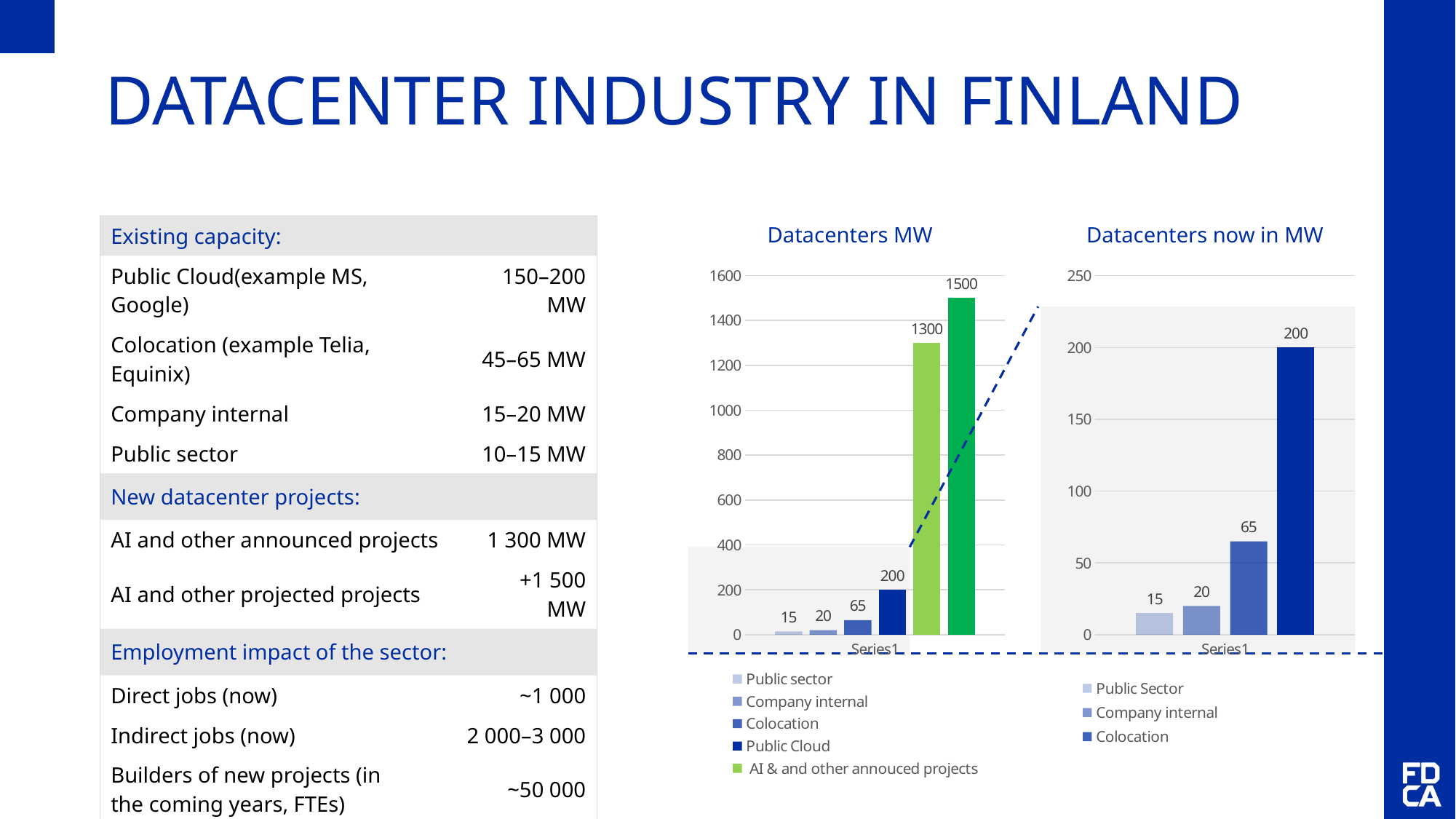
In the "Datacenters MW" chart, what is the value for AI & and other annouced projects? 1300 In the "Datacenters now in MW" chart, what is the value of the tallest bar? 200 In the "Datacenters MW" chart, which legend series has the lowest value? Public sector In the "Datacenters MW" chart, what is the highest value shown on a data label? 1500 In the "Datacenters MW" chart, what is the value for Colocation? 65 In the "Datacenters now in MW" chart, which is larger, Colocation or Public Sector? Colocation In the "Datacenters now in MW" chart, what is the value for Company internal? 20 In the "Datacenters MW" chart, what is the value for Public Cloud? 200 What type of chart is the "Datacenters MW" chart? Bar chart In the "Datacenters MW" chart, what is the difference between the AI & and other annouced projects value and the Public Cloud value? 1100 How many series does the legend of the "Datacenters now in MW" chart list? 3 In the "Datacenters now in MW" chart, what is the difference between Colocation and Company internal? 45